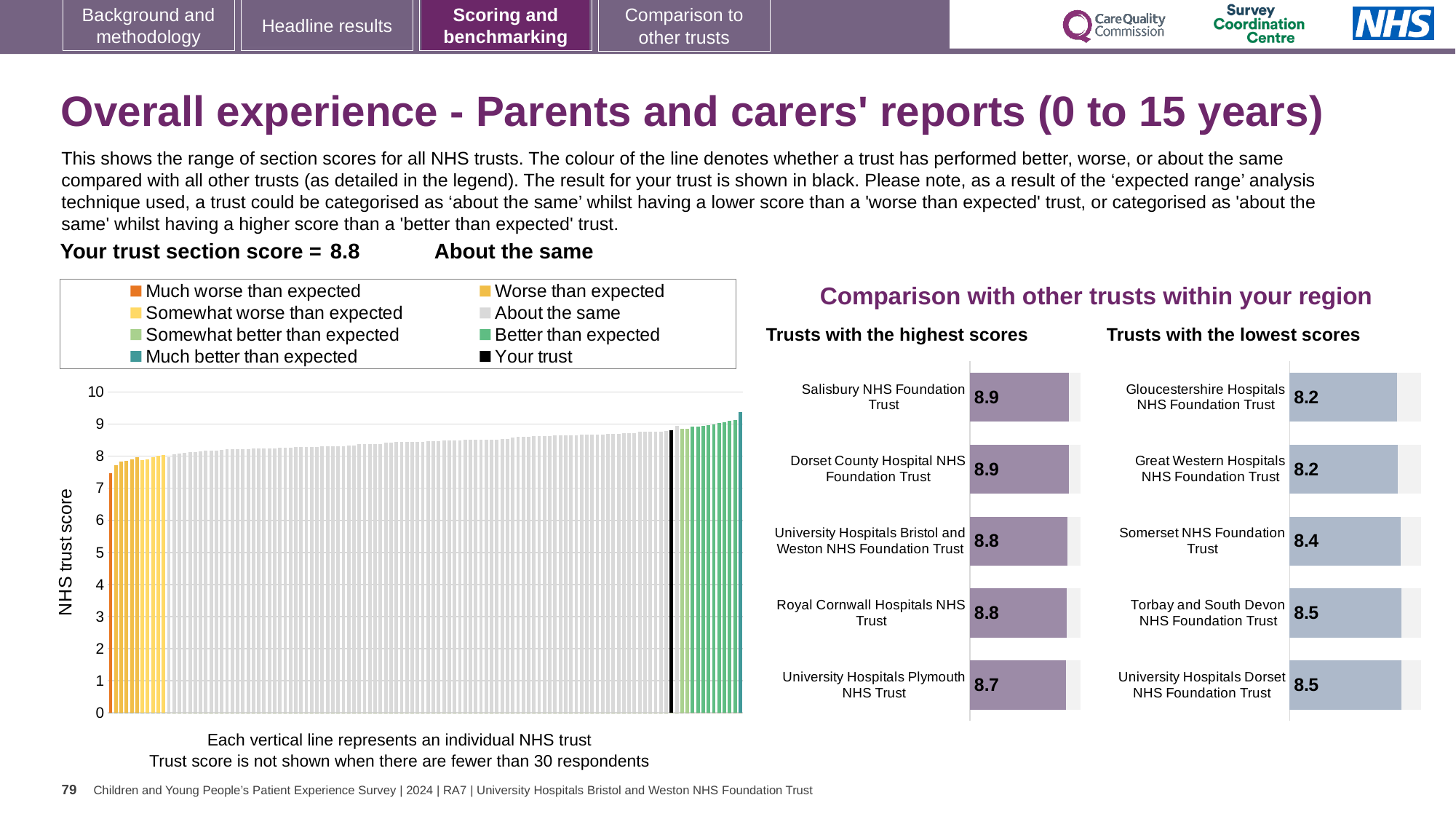
In the 'Trusts with the highest scores' chart, what is the difference between the scores of Salisbury NHS Foundation Trust and University Hospitals Plymouth NHS Trust? 0.2 How many trusts are shown in the 'Trusts with the lowest scores' chart? 5 In the 'Trusts with the lowest scores' chart, which has the larger score: Torbay and South Devon NHS Foundation Trust or Gloucestershire Hospitals NHS Foundation Trust? Torbay and South Devon NHS Foundation Trust In the large chart on the left, do the bar heights rise or fall from left to right along the x axis? Rise In the 'Trusts with the lowest scores' chart, what is the score for Somerset NHS Foundation Trust? 8.4 How many entries does the legend above the large chart on the left list? 8 In the large chart on the left, is the value of the black bar (Your trust) greater or less than 8? greater In the large chart on the left, is the value of the leftmost (orange) bar greater or less than 8? less In the 'Trusts with the highest scores' chart, what is the score for Salisbury NHS Foundation Trust? 8.9 In the 'Trusts with the highest scores' chart, which trust has the lowest score? University Hospitals Plymouth NHS Trust What kind of chart is the large chart on the left with the y axis labelled 'NHS trust score'? Bar chart What is the section score for your trust shown on the slide? 8.8